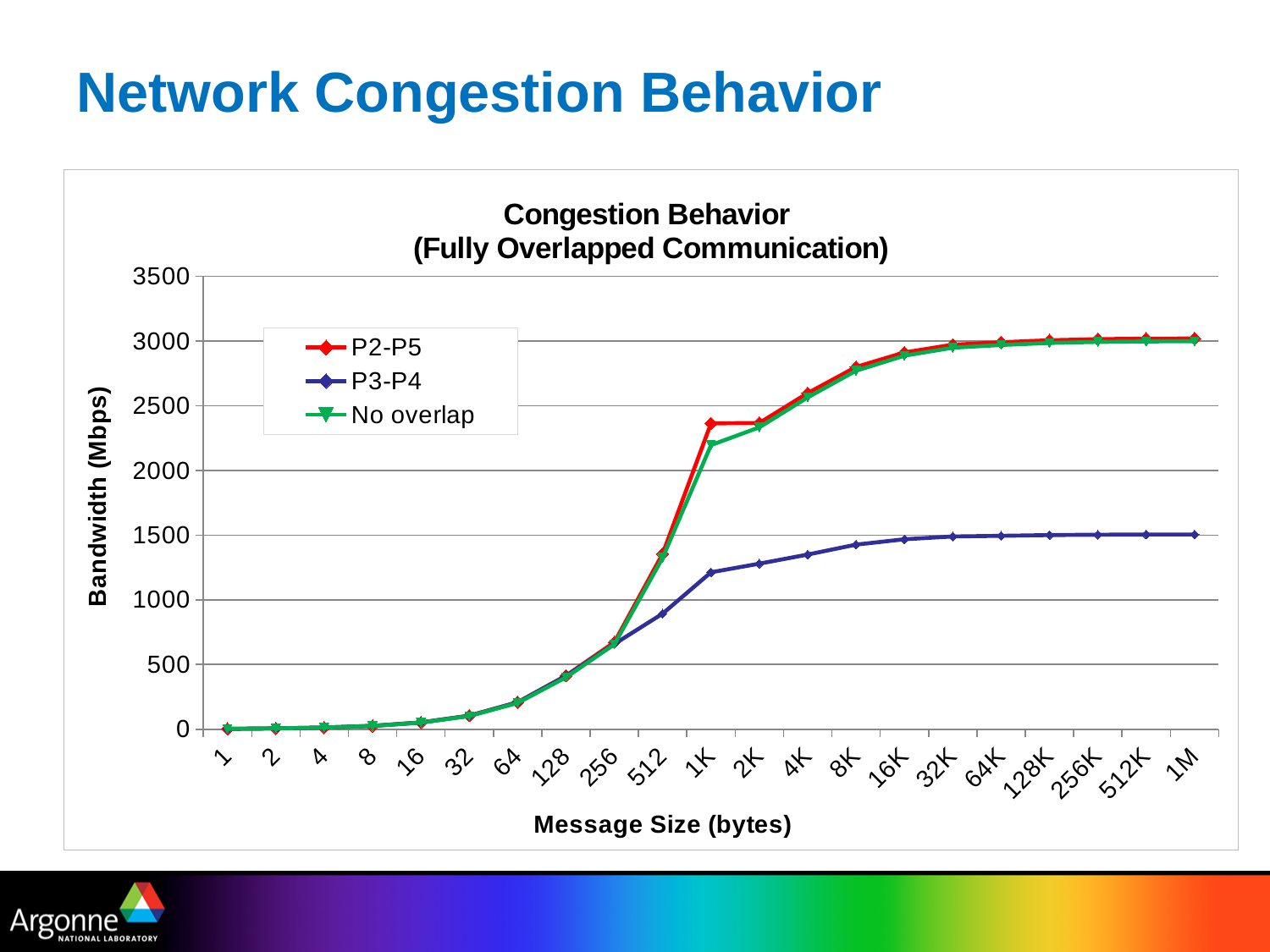
Is the bandwidth for P3-P4 at a message size of 512 greater or less than 1000? less How many series does the legend list? 3 Which series has the lowest bandwidth at a message size of 1M? P3-P4 What is the label of the y axis? Bandwidth (Mbps) At a message size of 1M, which series has the higher bandwidth, P2-P5 or P3-P4? P2-P5 What kind of chart is shown on the slide? line chart How many message sizes are plotted along the x axis? 21 Does the bandwidth for P3-P4 rise or fall as message size increases along the x axis? rise Is the bandwidth for P2-P5 at a message size of 4K greater or less than 2500? greater At a message size of 1K, which series has the higher bandwidth, P2-P5 or No overlap? P2-P5 Is the bandwidth for P2-P5 at a message size of 1K greater or less than 2000? greater